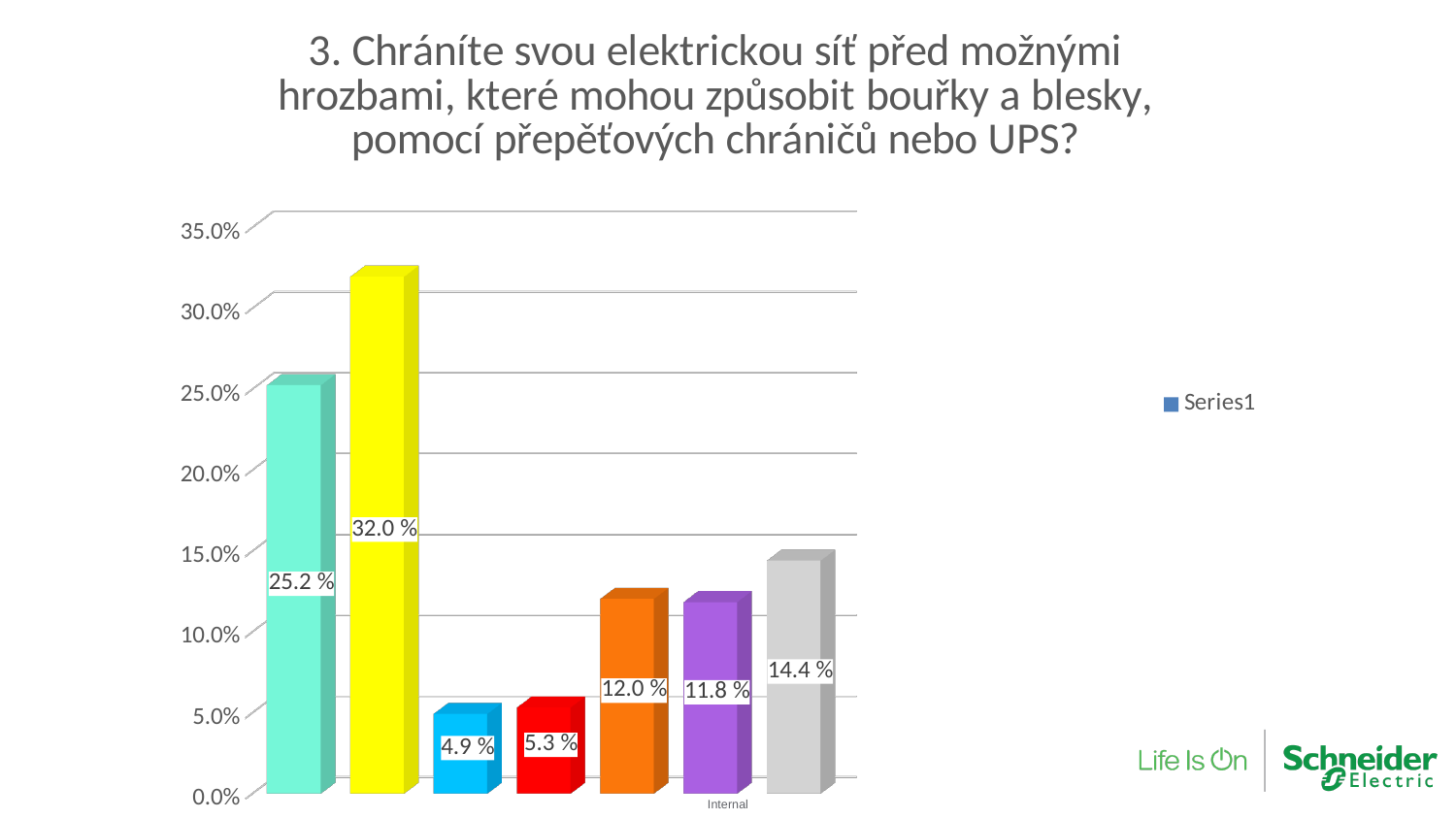
Which is larger, the value of the red bar or the value of the blue bar? The red bar (5.3 %) Which bar has the lowest value? The blue bar (4.9 %) How many bars are plotted in the chart? 7 What is the value shown on the grey bar at the far right? 14.4 % What kind of chart is shown on the slide? Bar chart What is the value shown on the orange bar? 12.0 % Is the value of the purple bar greater or less than 10.0%? greater What is the difference between the yellow bar's value and the teal bar's value? 6.8 % What is the value shown on the first (teal) bar from the left? 25.2 % How many series does the legend list? 1 What is the value shown on the yellow bar? 32.0 % Which bar has the highest value? The yellow bar (32.0 %)